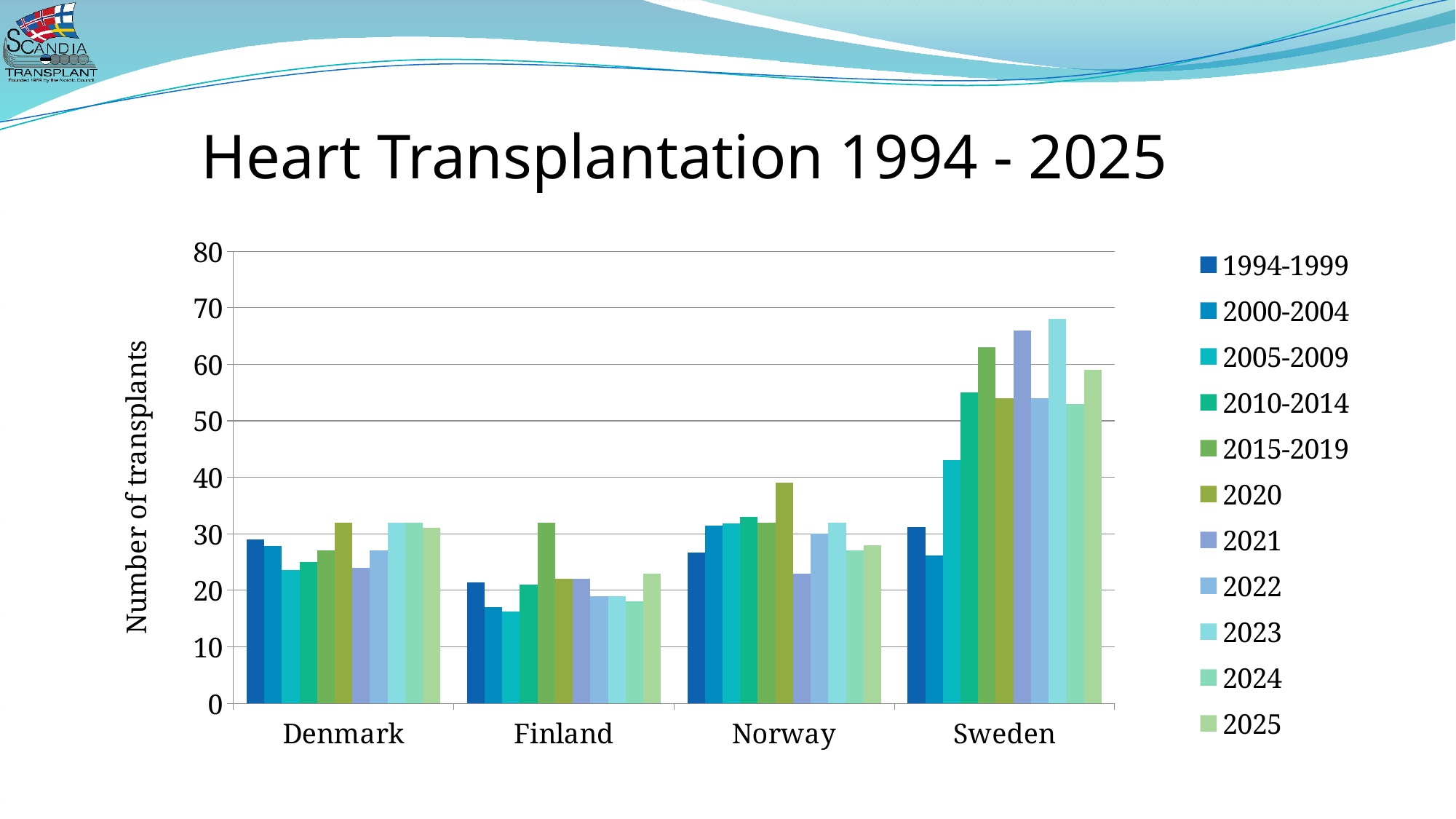
How many countries are shown on the x axis? 4 Is the value for Sweden in 1994-1999 greater or less than 40? less For Finland, which is larger, the 2015-2019 value or the 2000-2004 value? 2015-2019 Is the value for Sweden in 2023 greater or less than 60? greater Which is larger, the 2021 value for Sweden or the 2021 value for Denmark? Sweden Which country has the tallest bar in the chart? Sweden What kind of chart is shown on the slide? bar chart Is the value for Finland in 2005-2009 greater or less than 20? less Which country has the lowest bar for the 2005-2009 series? Finland How many series does the legend list? 11 What is the label on the vertical axis? Number of transplants